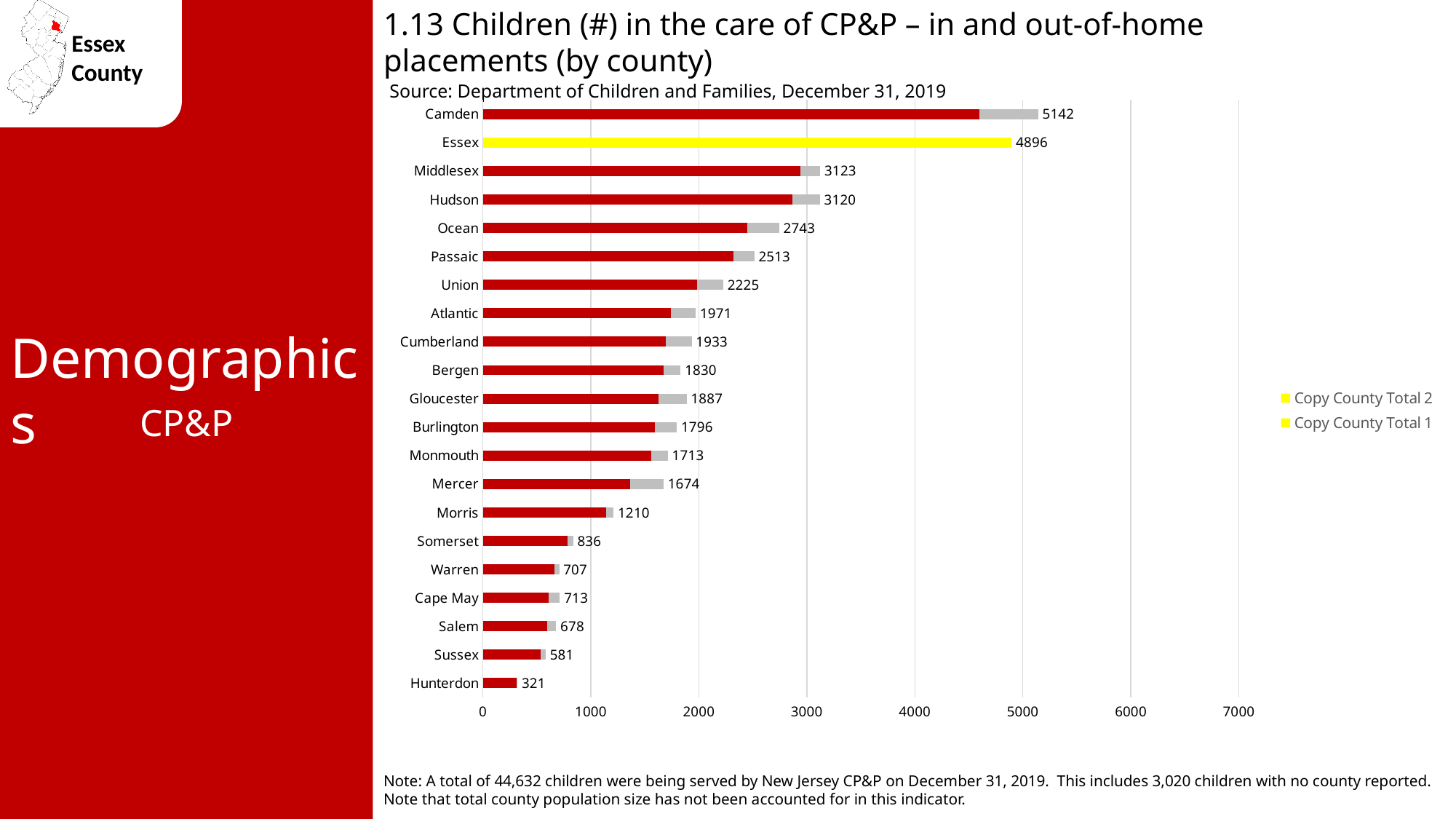
How many counties are shown on the chart? 21 Which has a larger value, Gloucester or Bergen? Gloucester How many more children are in the care of CP&P in Camden than in Essex? 246 Is the value for Ocean greater or less than 2000? greater How many entries does the legend list? 2 What is the difference between the values for Morris and Somerset? 374 What is the value shown for Hunterdon? 321 Which county has the highest number of children in the care of CP&P? Camden What is the total number of children in the care of CP&P shown for Camden? 5142 What value is labelled for Essex County? 4896 Which county has the lowest number of children in the care of CP&P? Hunterdon What kind of chart is used on this slide? Bar chart